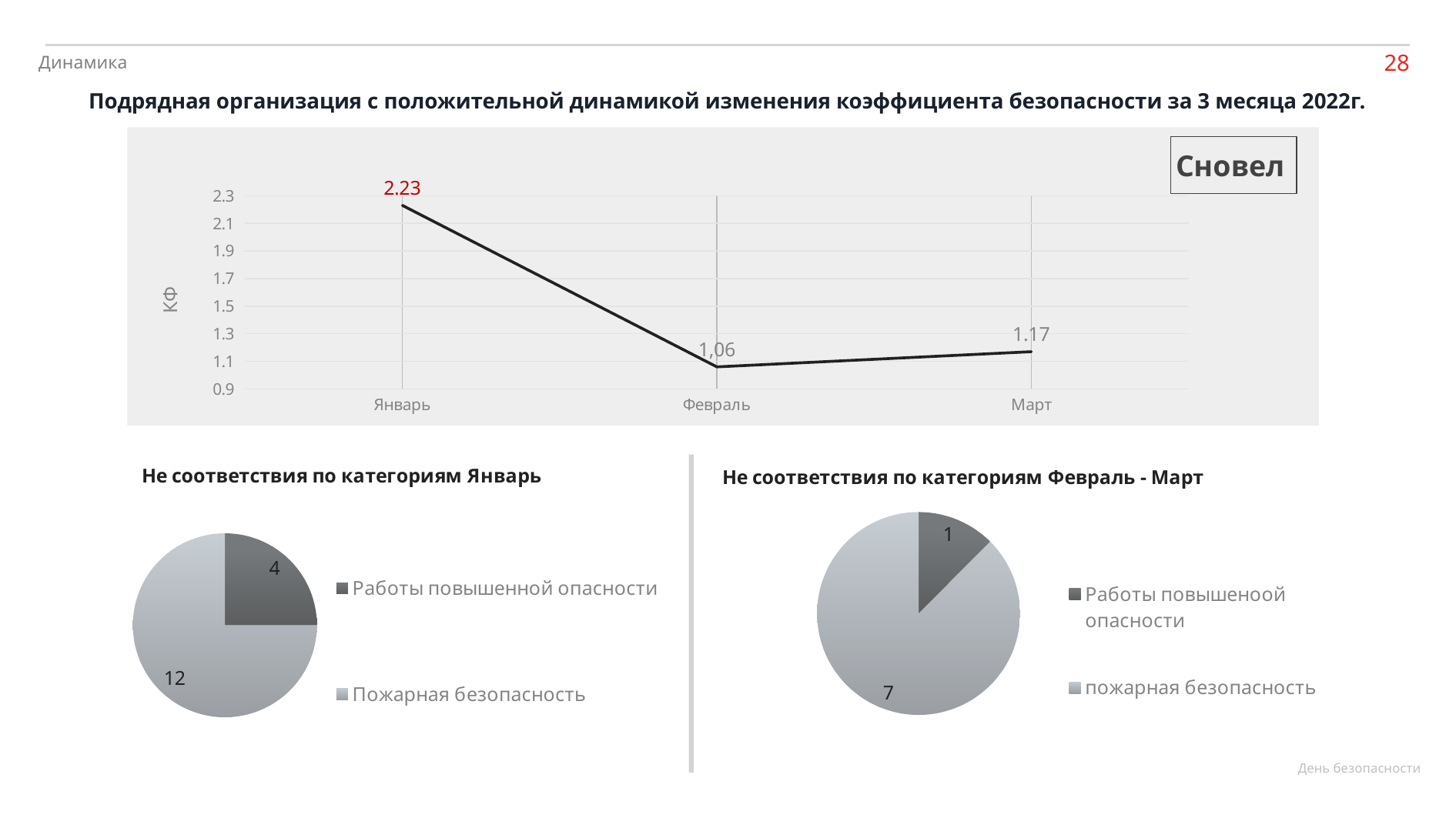
In the pie chart 'Не соответствия по категориям Январь', what share of the pie does Работы повышенной опасности represent? 25% In the top line chart, what is the value for Март? 1.17 In the top line chart, which month has the highest value? Январь In the top line chart, which month has the lowest value? Февраль What organisation name is shown in the box in the top chart? Сновел In the top line chart, how many months are plotted on the x axis? 3 In the pie chart 'Не соответствия по категориям Январь', what is the value for Пожарная безопасность? 12 In the pie chart 'Не соответствия по категориям Февраль - Март', what is the difference between пожарная безопасность and Работы повышеноой опасности? 6 In the top line chart, what is the value for Январь? 2.23 In the top line chart, what is the difference between the values for Январь and Март? 1.06 In the pie chart 'Не соответствия по категориям Февраль - Март', what is the value for Работы повышеноой опасности? 1 What kind of chart is the top chart on the slide? line chart